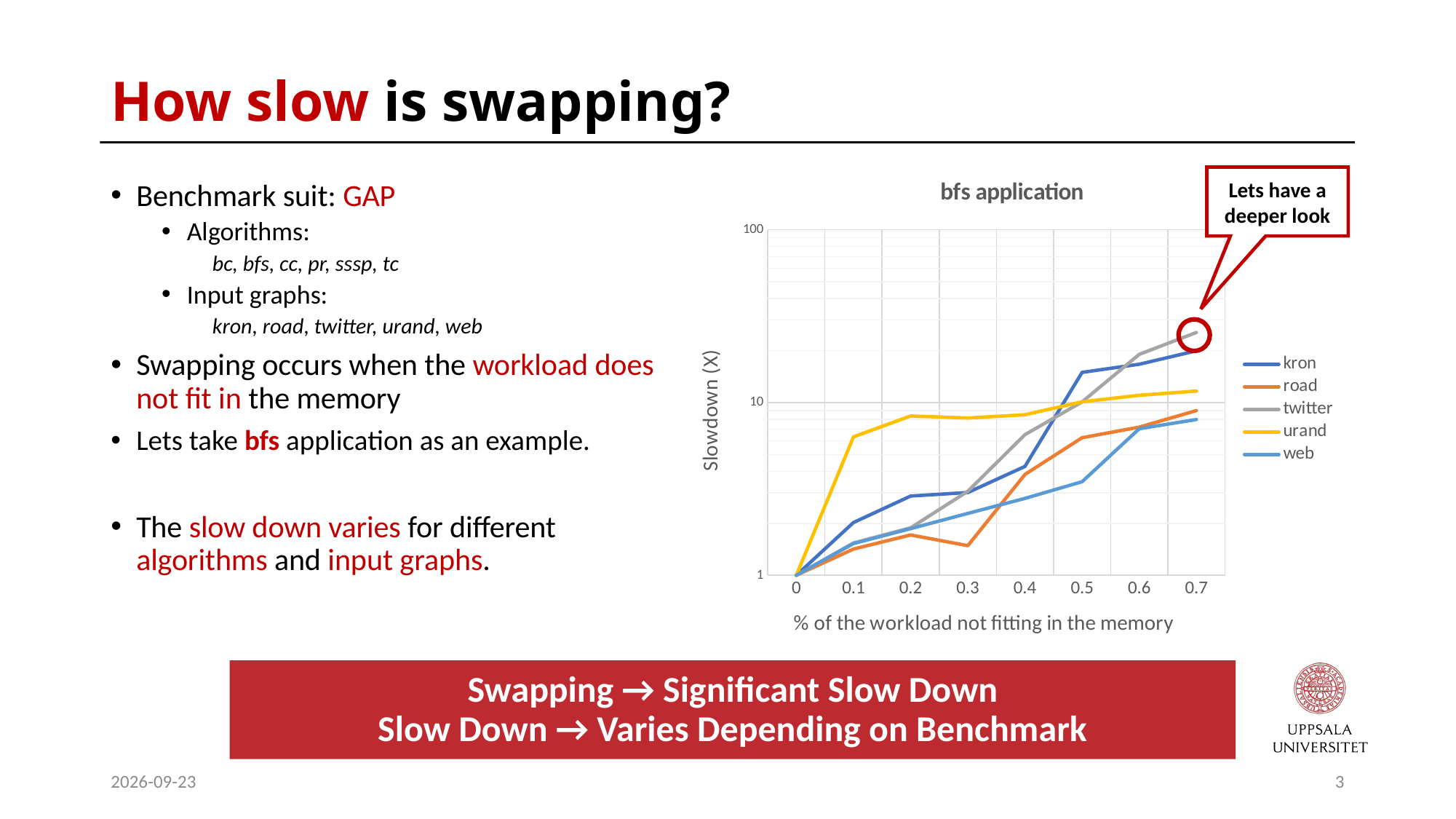
Which series has the highest slowdown at 0.7 on the x axis? twitter How many x-axis points are plotted for each series in the chart? 8 What kind of chart is shown on the slide? line chart Is the slowdown for twitter at 0.7 greater or less than 10? greater Which series has the highest slowdown at 0.1 on the x axis? urand Is the slowdown for urand at 0.1 greater or less than 10? less Which series has the lowest slowdown at 0.7 on the x axis? web What is the title of the chart? bfs application At 0.5 on the x axis, which series has the larger slowdown, kron or road? kron How many series does the chart's legend list? 5 Does the slowdown for kron rise or fall as the percentage of the workload not fitting in memory increases? rise What is the label of the y axis of the chart? Slowdown (X)